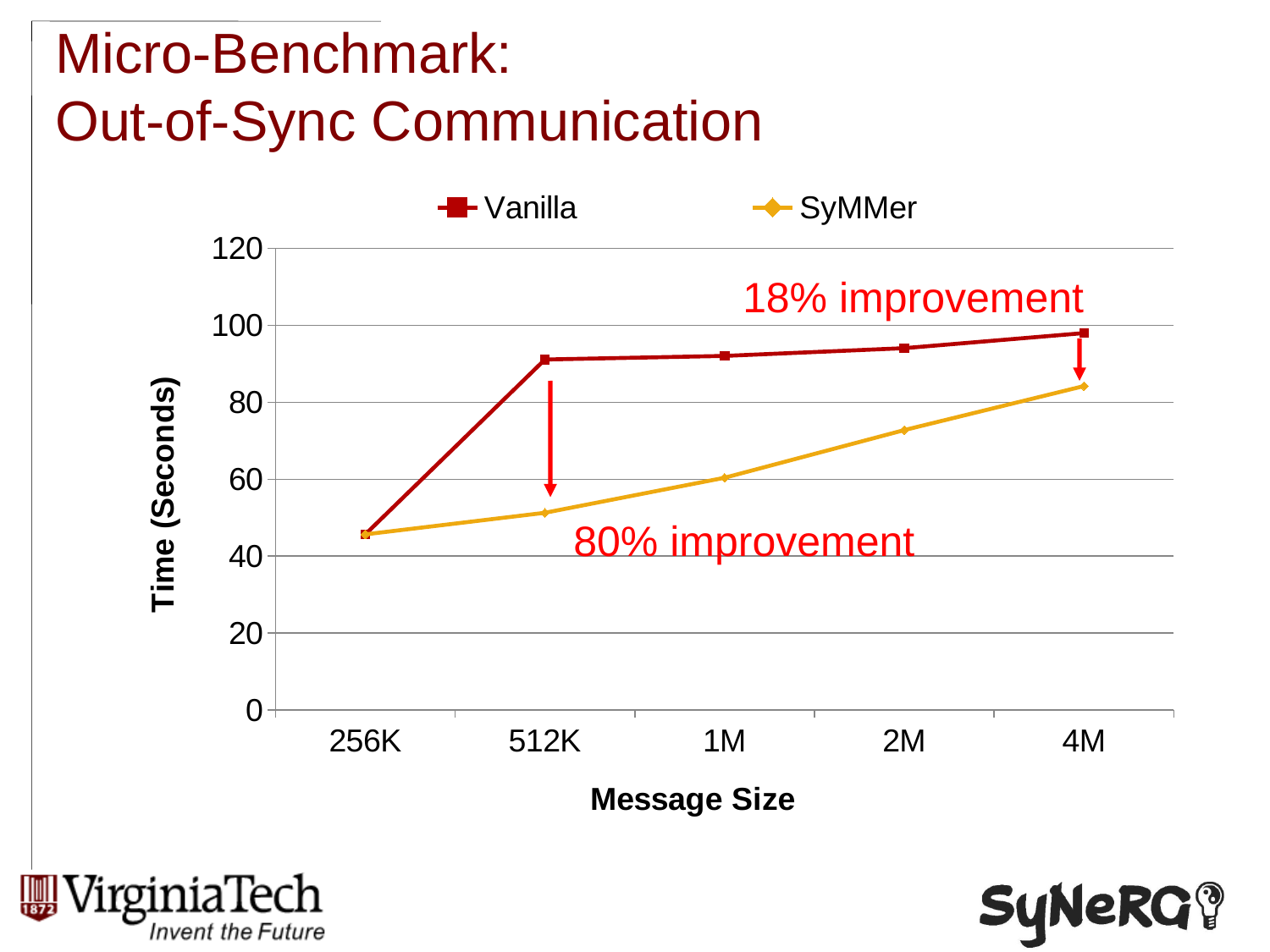
Is the SyMMer value at 512K greater or less than 40 seconds? greater What kind of chart is shown on the slide? line chart At which message size does the SyMMer series reach its highest time? 4M Is the Vanilla value at 256K greater or less than 60 seconds? less Is the Vanilla value at 512K greater or less than 80 seconds? greater Does the SyMMer series rise or fall as message size increases from 256K to 4M? rise At message size 512K, which series has the larger time, Vanilla or SyMMer? Vanilla At which message size does the Vanilla series have its lowest time? 256K How many message sizes are plotted along the x axis? 5 What improvement percentage is annotated at message size 512K? 80% improvement How many series does the legend list? 2